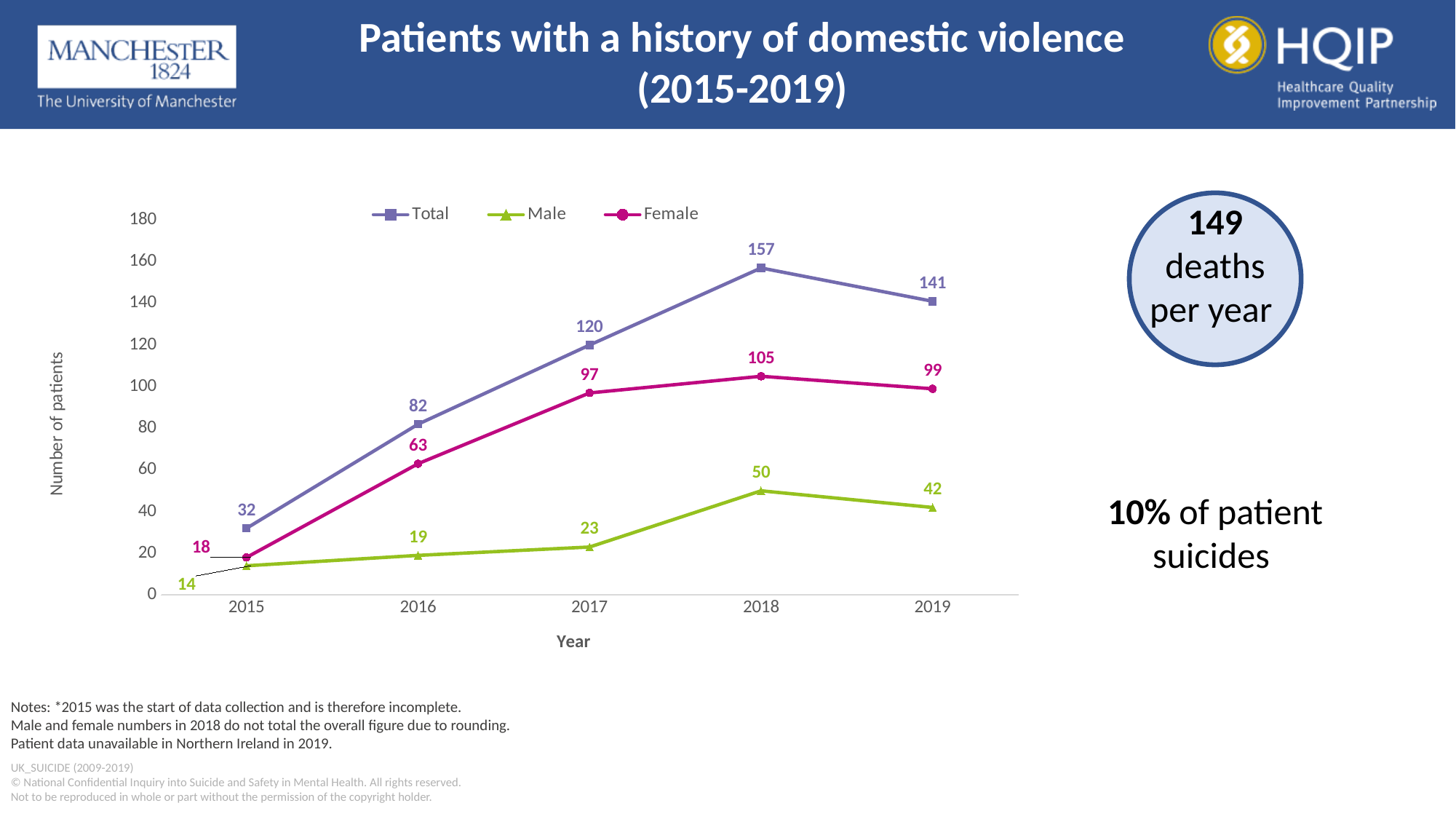
What is the Male value for 2019? 42 What kind of chart is shown on the slide? line chart What is the Female value for 2016? 63 How many years are shown on the x axis? 5 In which year is the Total series highest? 2018 How many series does the legend list? 3 Does the Female series rise or fall from 2015 to 2018? rise What is the difference between the Total values for 2018 and 2019? 16 Which is larger, the Female value for 2017 or the Male value for 2018? Female value for 2017 What is the Total value for 2018? 157 Is the Total value for 2017 greater or less than 100? greater In which year is the Male series lowest? 2015